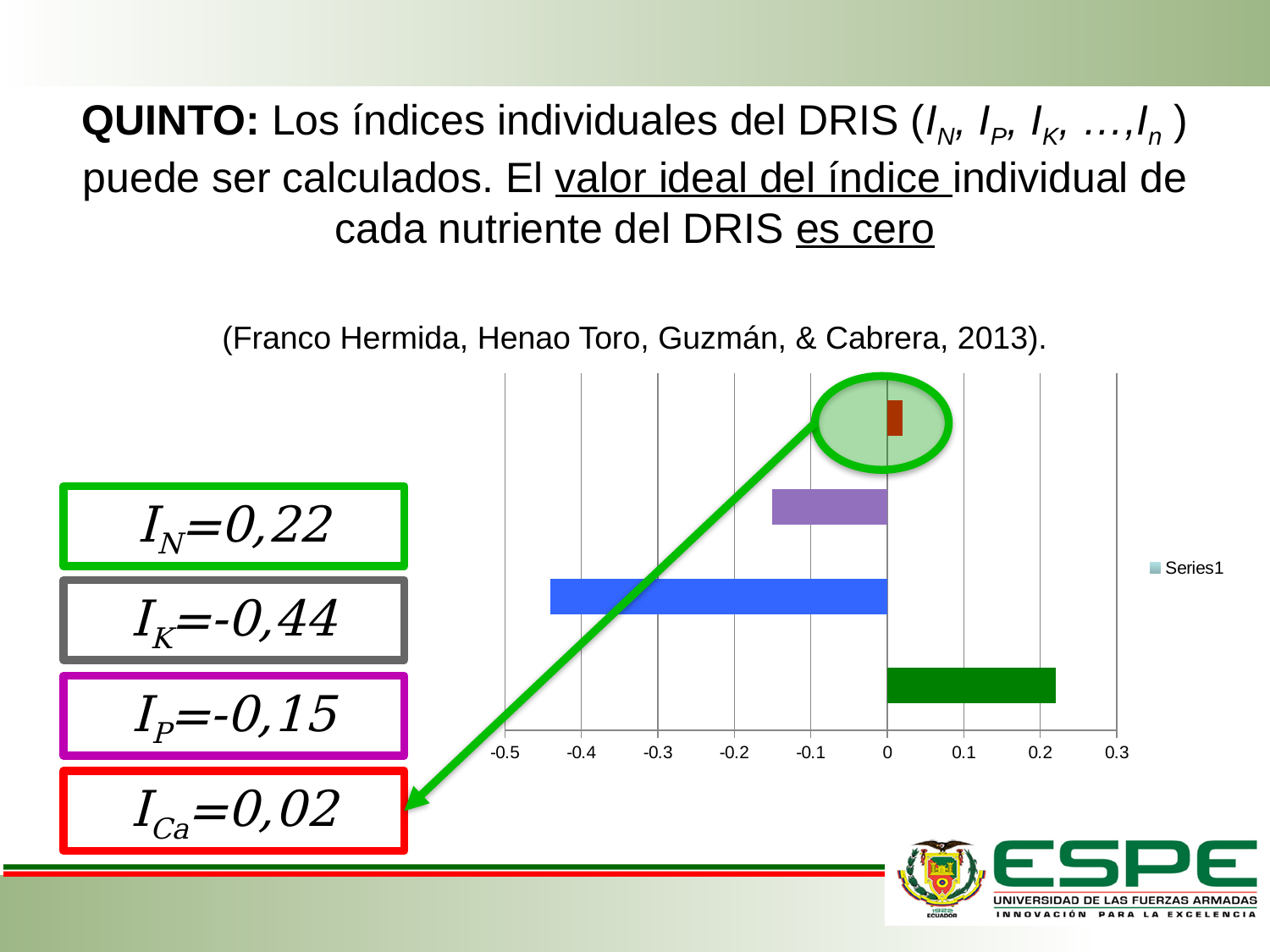
Is the value of the green bar greater or less than 0.1? greater According to the slide, what is the value of the index I_K? -0,44 What is the name of the series shown in the chart legend? Series1 Which bar has the lowest (most negative) value? the blue bar How many bars are plotted in the chart? 4 Is the value of the blue bar greater or less than -0.3? less What is the lowest tick value shown on the horizontal axis of the chart? -0.5 According to the slide, what is the value of the index I_Ca, the small circled bar the arrow points to? 0,02 How many series does the chart legend list? 1 Is the value of the purple bar greater or less than -0.2? greater Which bar extends furthest to the right (has the highest value)? the green bar What kind of chart is shown on the slide? bar chart